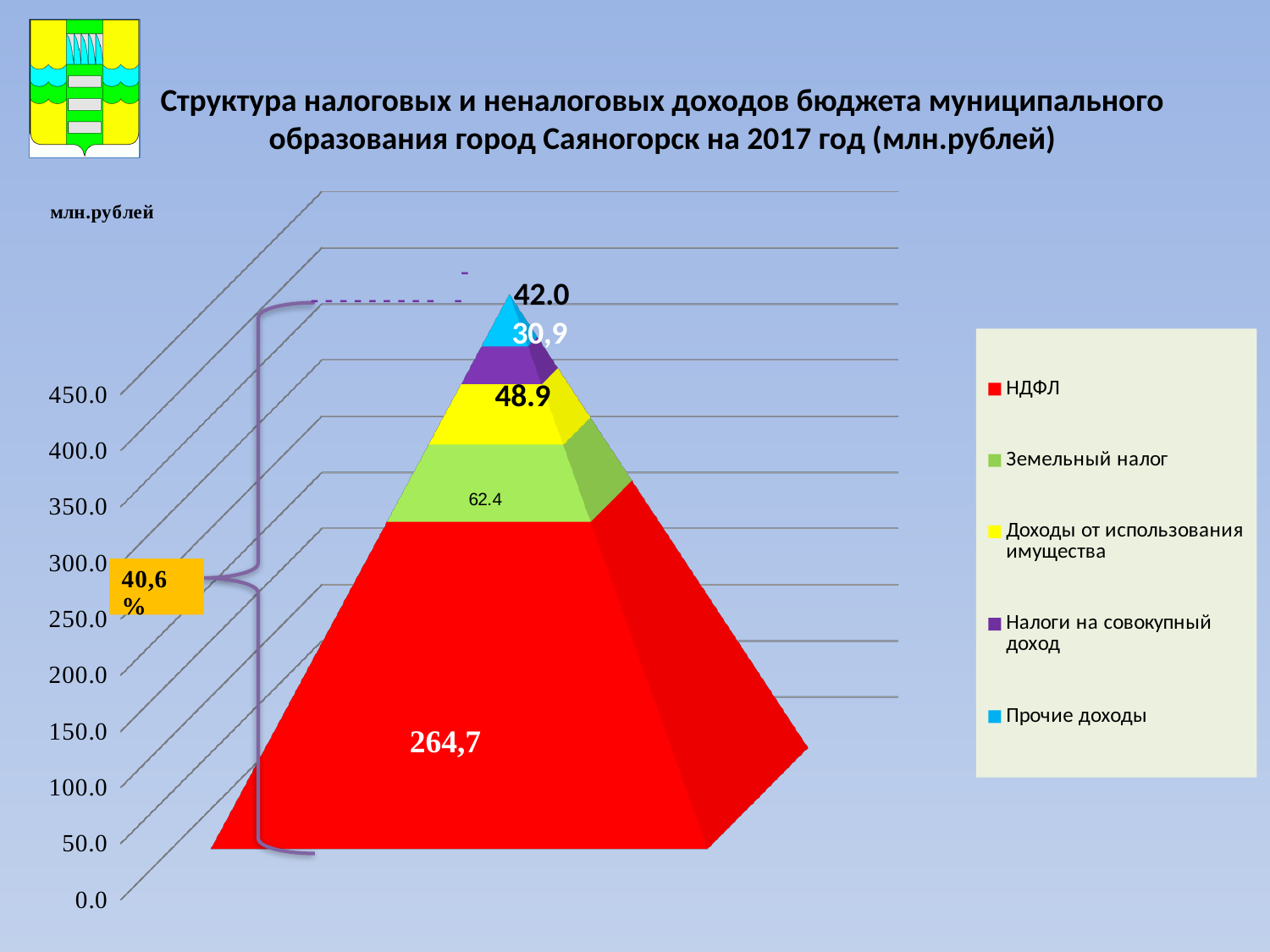
What is the value for Доходы от использования имущества? 48.9 What percentage is shown in the orange label next to the chart? 40,6% What is the smallest value labelled on the chart? 30,9 What is the value for Земельный налог? 62.4 What is the total of all the stacked segments? 448.9 What kind of chart is shown? stacked pyramid chart Which series has the largest value? НДФЛ How many series does the legend list? 5 Is the value for НДФЛ greater or less than 250? greater Which is larger, the value for Земельный налог or the value for Доходы от использования имущества? Земельный налог What is the value for НДФЛ? 264,7 What is the difference between the values for НДФЛ and Земельный налог? 202.3